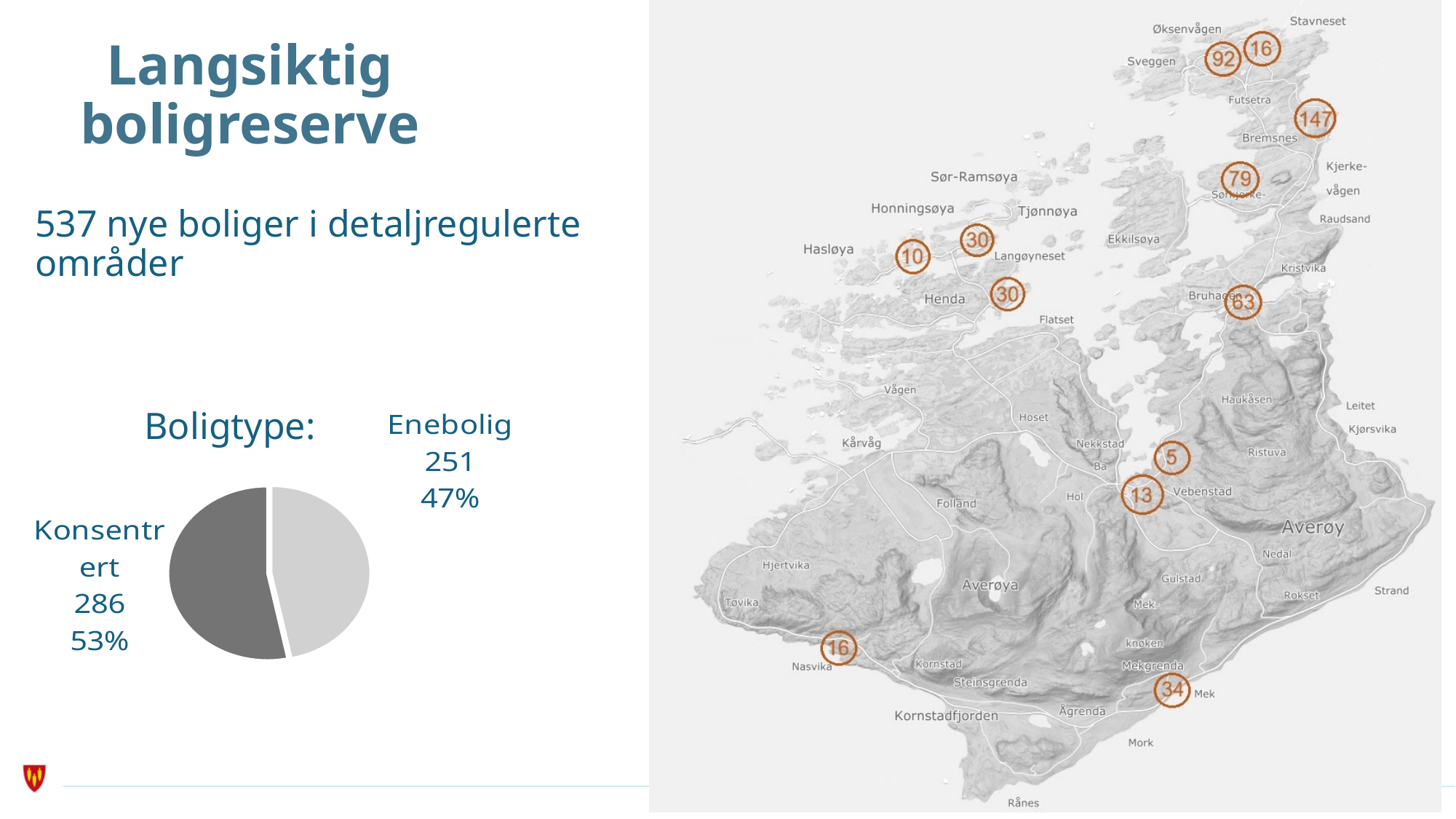
In the "Boligtype:" pie chart, which is larger, Enebolig or Konsentrert? Konsentrert In the "Boligtype:" pie chart, how many dwellings are Konsentrert? 286 How many slices does the "Boligtype:" pie chart have? 2 What kind of chart is the "Boligtype:" chart? pie chart In the "Boligtype:" pie chart, which category is the smallest? Enebolig What is the title of the pie chart on the slide? Boligtype: In the "Boligtype:" pie chart, how many dwellings are Enebolig? 251 In the "Boligtype:" pie chart, what is the total of the two slices? 537 In the "Boligtype:" pie chart, what is the difference between the Konsentrert and Enebolig counts? 35 In the "Boligtype:" pie chart, what share of the pie is Konsentrert? 53% In the "Boligtype:" pie chart, which category is the largest? Konsentrert In the "Boligtype:" pie chart, what share of the pie is Enebolig? 47%